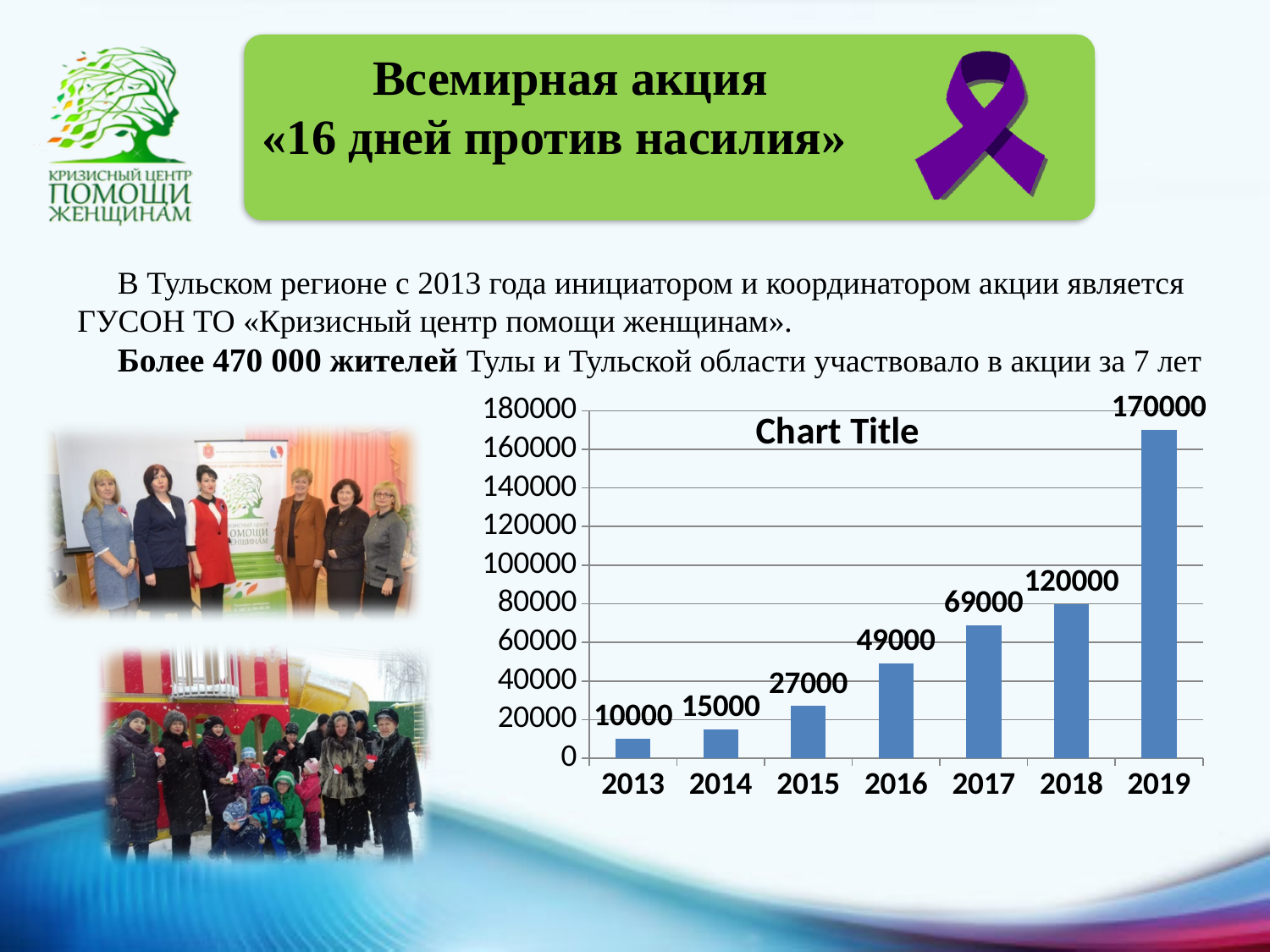
Which is larger, the value for 2017 or the value for 2015? 2017 Which year has the lowest value in the chart? 2013 What kind of chart is shown on the slide? bar chart What is the difference between the values for 2017 and 2016? 20000 What is the value for 2019 in the chart? 170000 Do the values rise or fall from 2013 to 2019? rise What is the difference between the values for 2014 and 2013? 5000 Which year has the highest value in the chart? 2019 What is the value for 2015 in the chart? 27000 What is the value for 2016 in the chart? 49000 What is the value for 2013 in the chart? 10000 How many years are shown on the x axis of the chart? 7